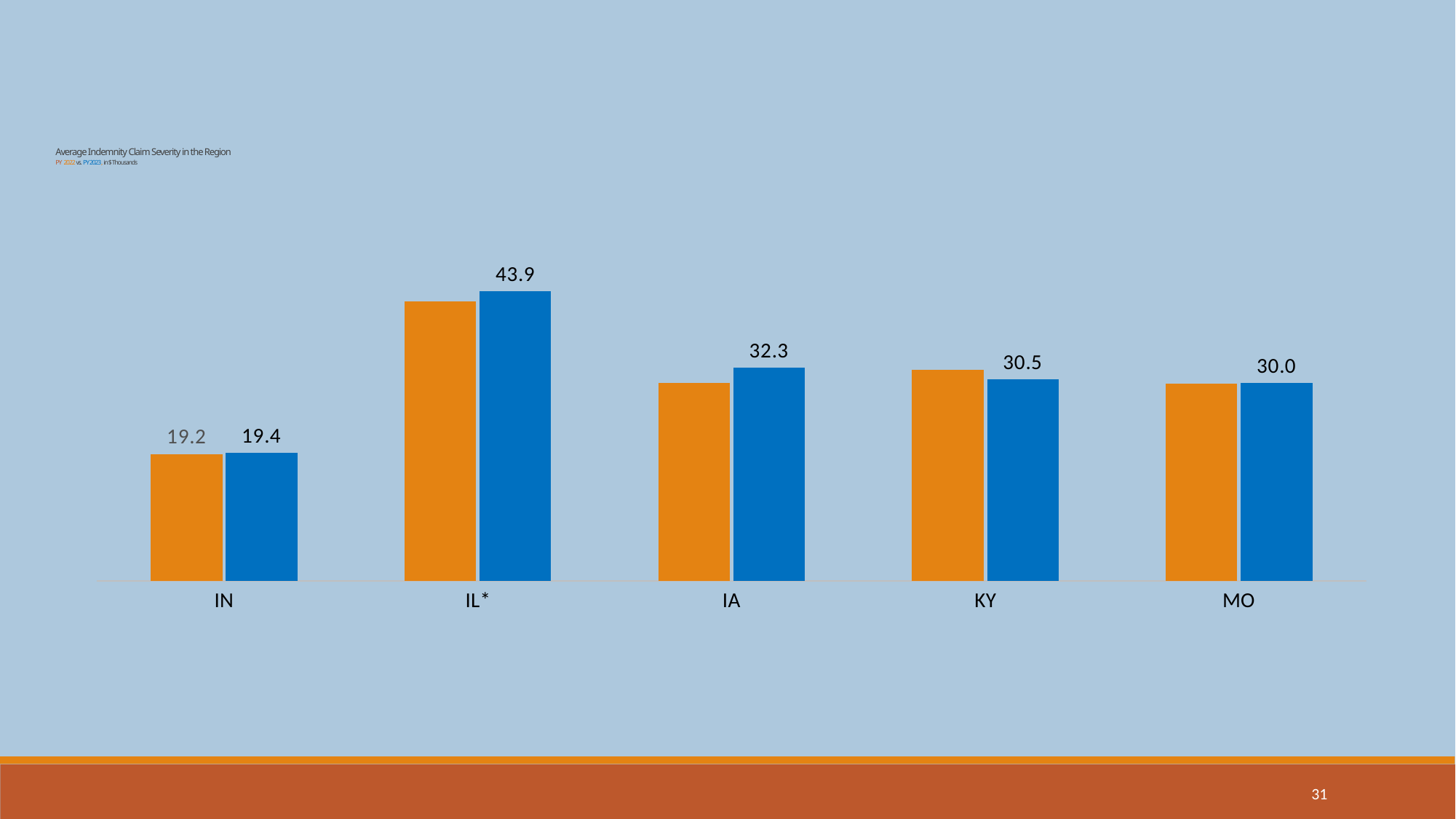
Which has the larger blue bar value, KY or MO? KY What is the value of the blue bar for IL*? 43.9 What is the value of the blue bar for KY? 30.5 How many categories are shown on the x axis? 5 Which category has the lowest blue bar? IN Which category has the highest blue bar? IL* What is the value of the blue bar for MO? 30.0 What is the difference between the blue and orange bar values for IN? 0.2 What is the difference between the blue bar values for IL* and IA? 11.6 What kind of chart is shown on the slide? Bar chart What is the value of the orange bar for IN? 19.2 What is the value of the blue bar for IA? 32.3